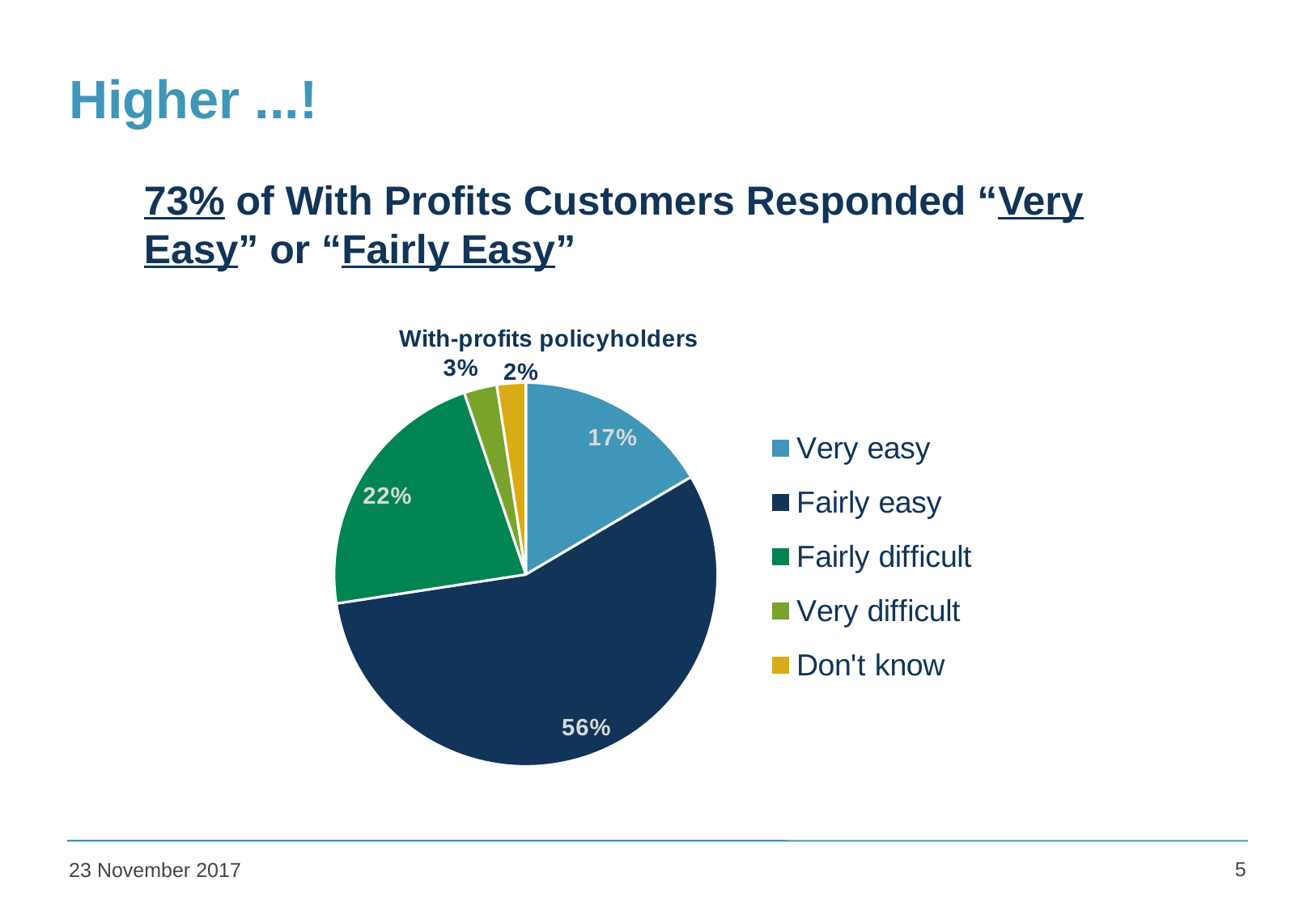
What percentage of with-profits policyholders responded "Fairly easy"? 56% What percentage of with-profits policyholders responded "Don't know"? 2% What type of chart is shown on the slide? Pie chart What is the combined share of "Very easy" and "Fairly easy"? 73% What is the title of the chart? With-profits policyholders What percentage of with-profits policyholders responded "Fairly difficult"? 22% Which response category has the largest share of the pie? Fairly easy What is the difference in percentage points between "Fairly easy" and "Fairly difficult"? 34 What percentage of with-profits policyholders responded "Very easy"? 17% Which is larger, the share for "Very easy" or the share for "Fairly difficult"? Fairly difficult Which response category has the smallest share of the pie? Don't know How many categories does the pie chart show? 5